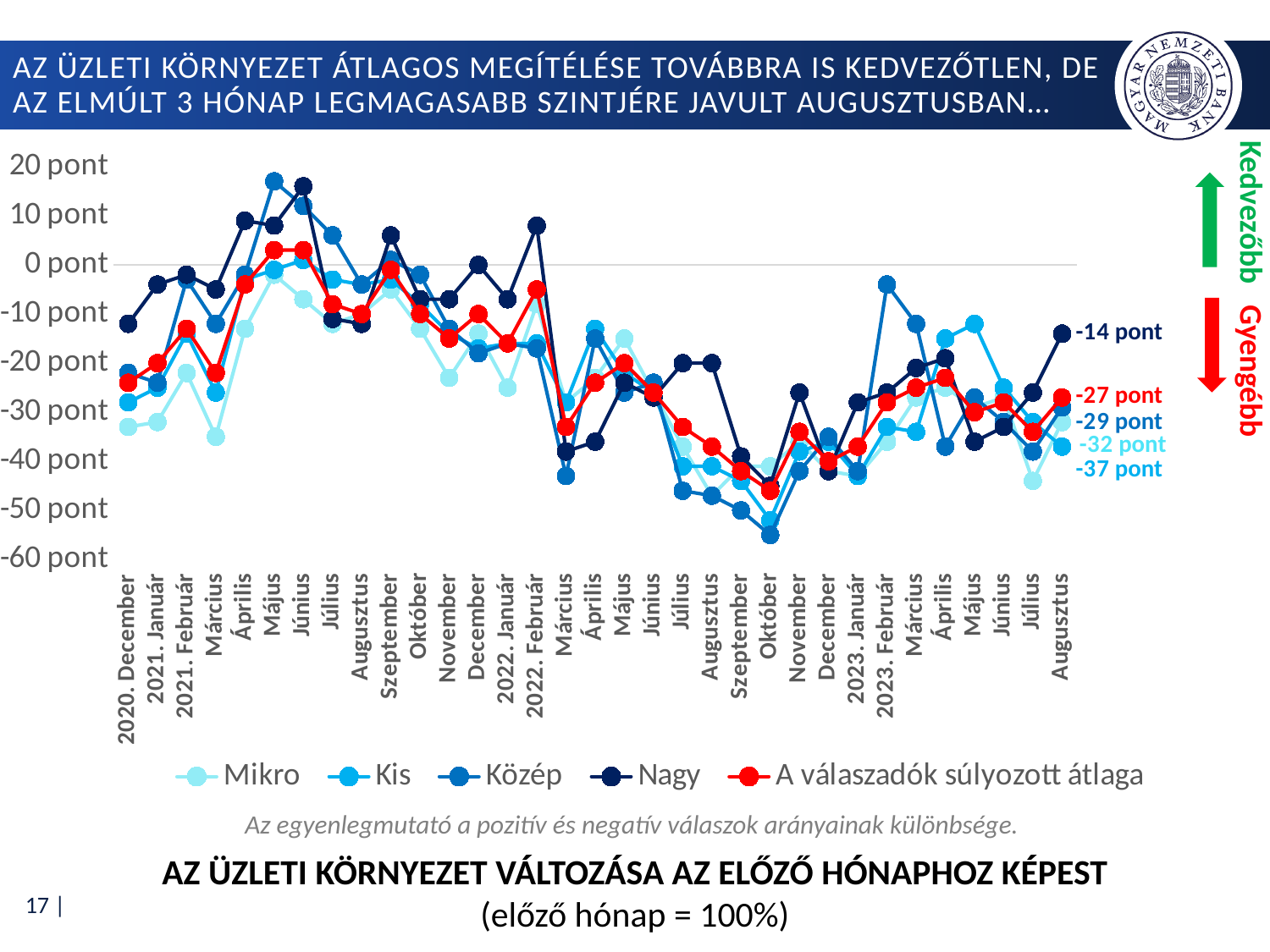
How many series does the legend list? 5 What label is written next to the green upward arrow on the right of the chart? Kedvezőbb Is the value of the Nagy series in 2022 Február greater or less than 0 pont? greater Which series has the highest value in 2023 Augusztus? Nagy What is the difference between the Nagy value and the weighted average ('A válaszadók súlyozott átlaga') in 2023 Augusztus? 13 pont What is the value of the Nagy series in 2023 Augusztus? -14 pont Is the value of 'A válaszadók súlyozott átlaga' in 2022 Október greater or less than -40 pont? less Did the weighted average ('A válaszadók súlyozott átlaga') rise or fall from 2023 Július to 2023 Augusztus? rise What is the value of the Közép series in 2023 Augusztus? -29 pont What kind of chart is shown on the slide? line chart In 2023 Augusztus, which is larger: the Nagy value or the Közép value? Nagy What is the value of 'A válaszadók súlyozott átlaga' in 2023 Augusztus? -27 pont